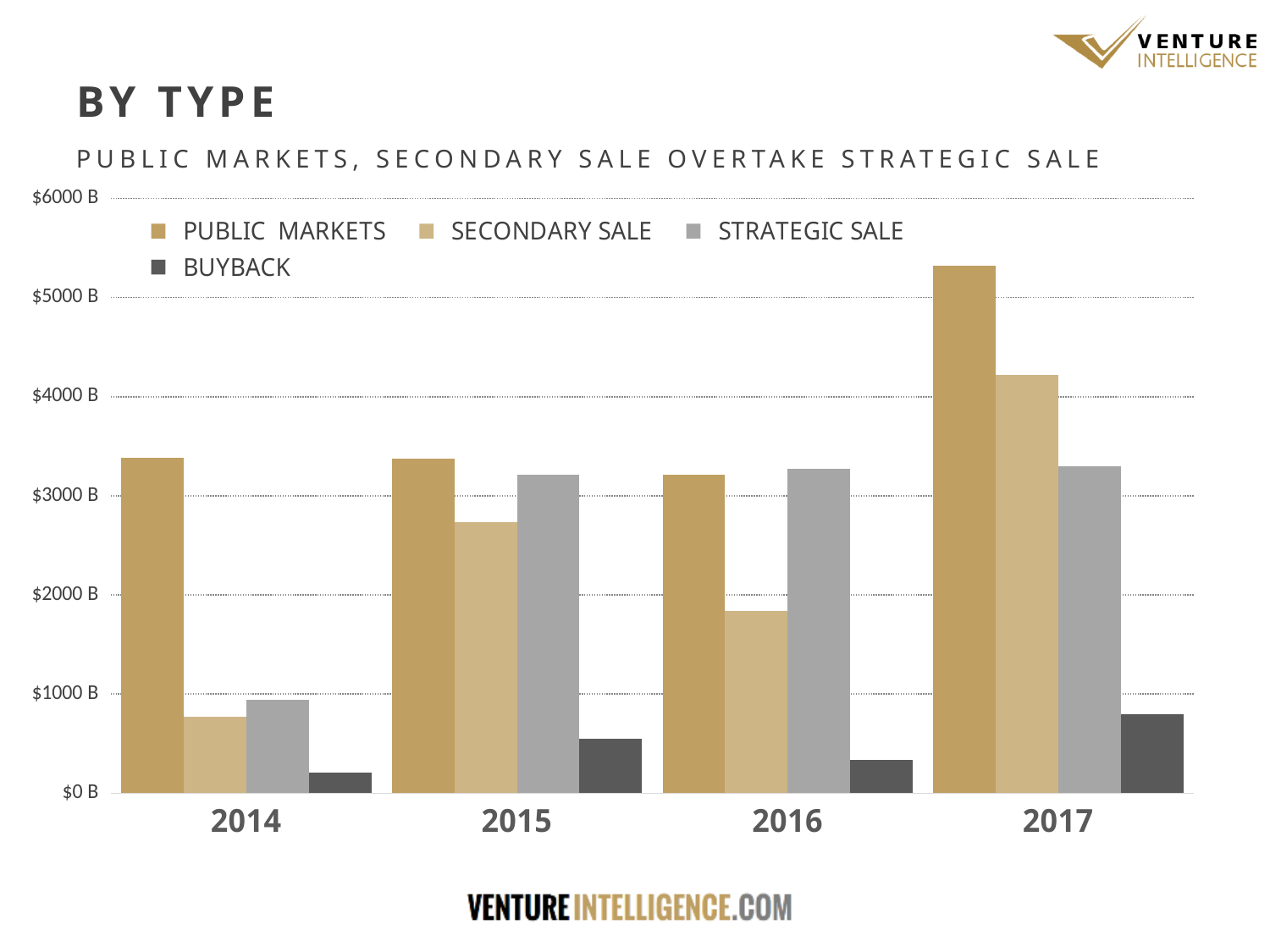
How many series does the legend list? 4 Is the value for Buyback in 2017 greater or less than $1000 B? less Is the value for Strategic Sale in 2015 greater or less than $3000 B? greater In 2014, which is larger: Public Markets or Strategic Sale? Public Markets What kind of chart is shown on the slide? bar chart Is the value for Public Markets in 2017 greater or less than $5000 B? greater In 2016, which is larger: Secondary Sale or Strategic Sale? Strategic Sale In which year is the Public Markets bar the highest? 2017 In which year is the Buyback bar the lowest? 2014 How many years are shown on the x axis? 4 Does the Strategic Sale series rise or fall from 2014 to 2017? rise